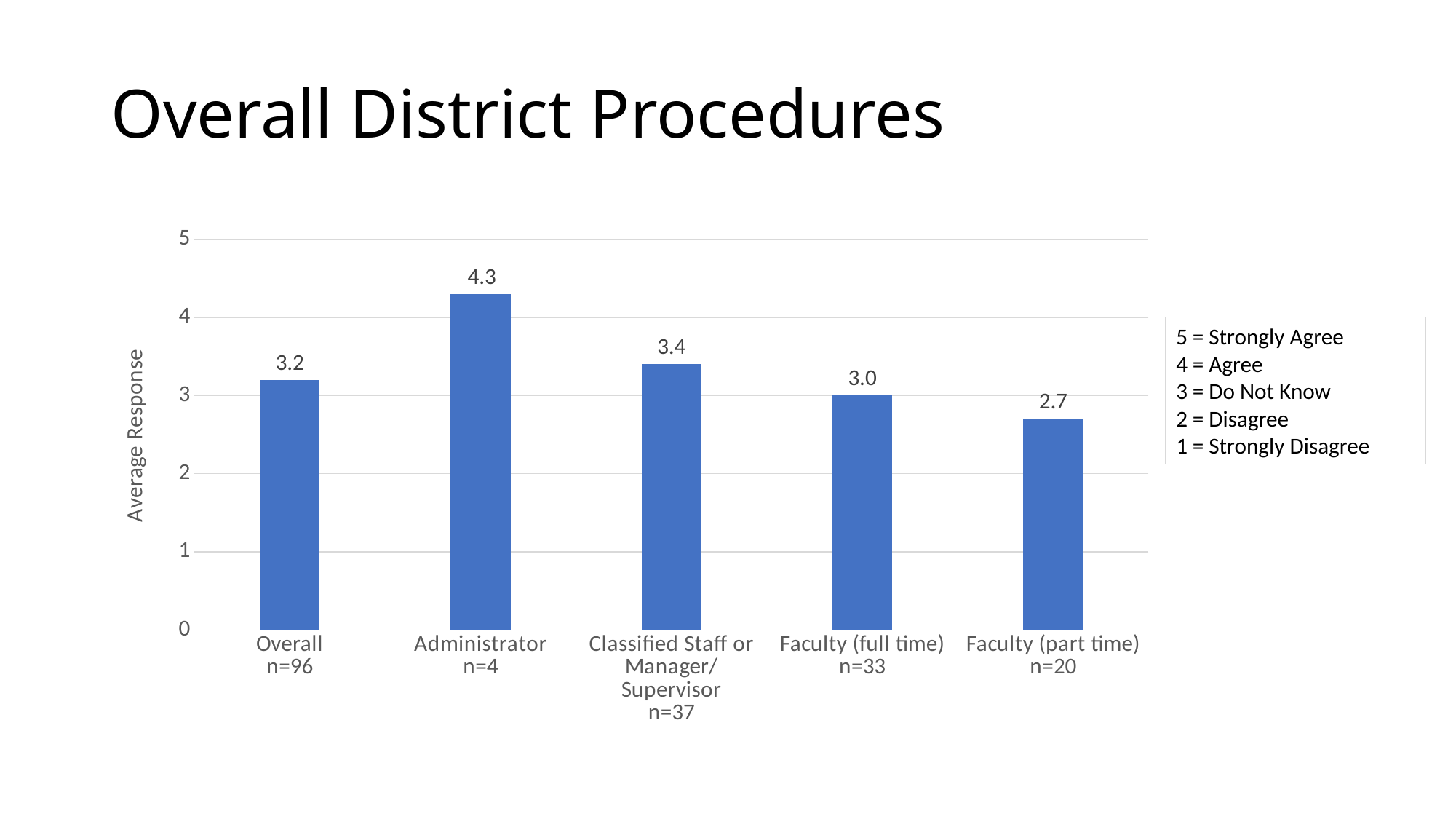
What kind of chart is shown on the slide? Bar chart What is the average response for Classified Staff or Manager/Supervisor (n=37)? 3.4 Which has a higher average response, Classified Staff or Manager/Supervisor or Faculty (full time)? Classified Staff or Manager/Supervisor Which group has the lowest average response? Faculty (part time) Which group has the highest average response? Administrator What is the Overall (n=96) average response? 3.2 How many groups are shown on the x axis of the chart? 5 Is the average response for Administrator greater or less than 4? greater What is the difference between the Administrator average response and the Faculty (part time) average response? 1.6 What is the average response for Faculty (part time) (n=20)? 2.7 What is the label of the vertical axis? Average Response What is the average response for Administrator (n=4)? 4.3